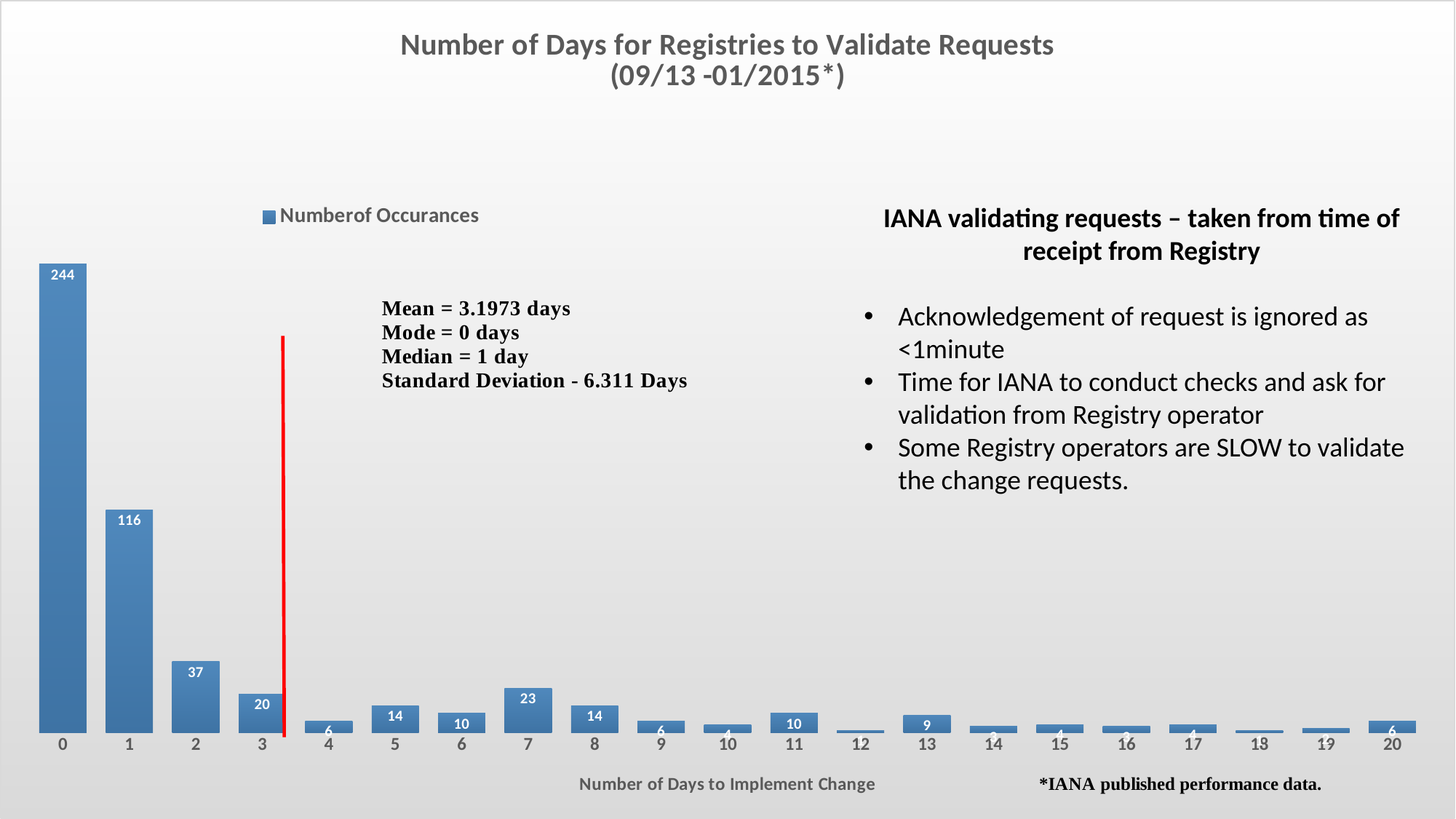
Do the values generally rise or fall as the number of days increases from 0 to 4? Fall How many day categories are shown on the x axis? 21 What is the Number of Occurances for 0 days? 244 What is the x-axis title of the chart? Number of Days to Implement Change Which number of days has the highest Number of Occurances? 0 What kind of chart is shown on the slide? Bar chart What is the Number of Occurances for 1 day? 116 What is the Number of Occurances for 13 days? 9 Which has more occurances, 2 days or 3 days? 2 days How many series does the legend list? 1 What is the Number of Occurances for 7 days? 23 What is the difference between the Number of Occurances for 0 days and for 1 day? 128